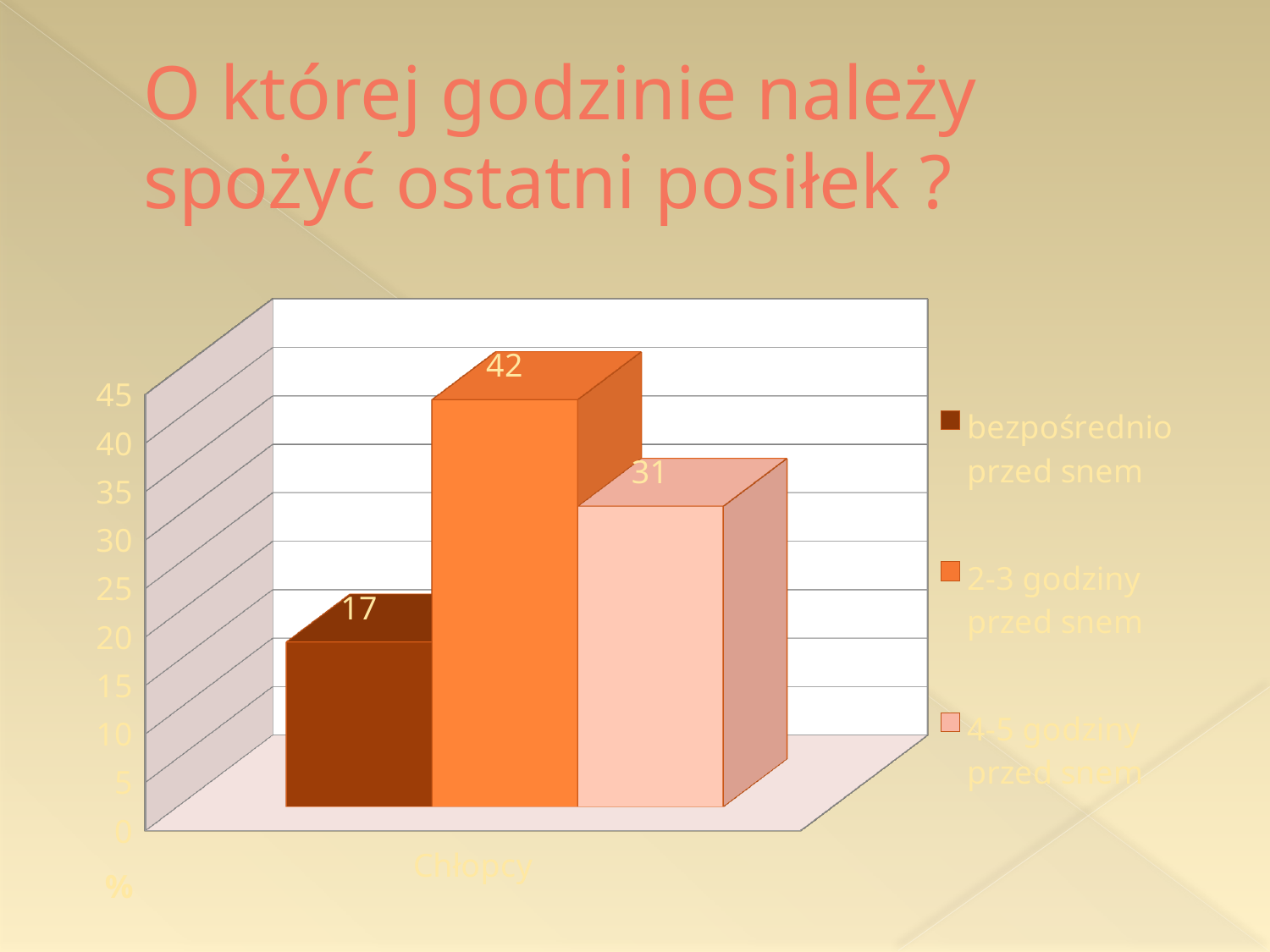
Is the value for "4-5 godziny przed snem" greater or less than 25? greater What is the difference between the values for "2-3 godziny przed snem" and "bezpośrednio przed snem"? 25 What kind of chart is shown on the slide? bar chart What is the category label shown on the x axis of the chart? Chłopcy Which series has the highest value? 2-3 godziny przed snem What is the difference between the values for "2-3 godziny przed snem" and "4-5 godziny przed snem"? 11 What is the value for "2-3 godziny przed snem"? 42 Which is larger, the value for "4-5 godziny przed snem" or the value for "bezpośrednio przed snem"? 4-5 godziny przed snem What is the value for "4-5 godziny przed snem"? 31 How many series does the legend list? 3 What is the value for "bezpośrednio przed snem"? 17 Which series has the lowest value? bezpośrednio przed snem